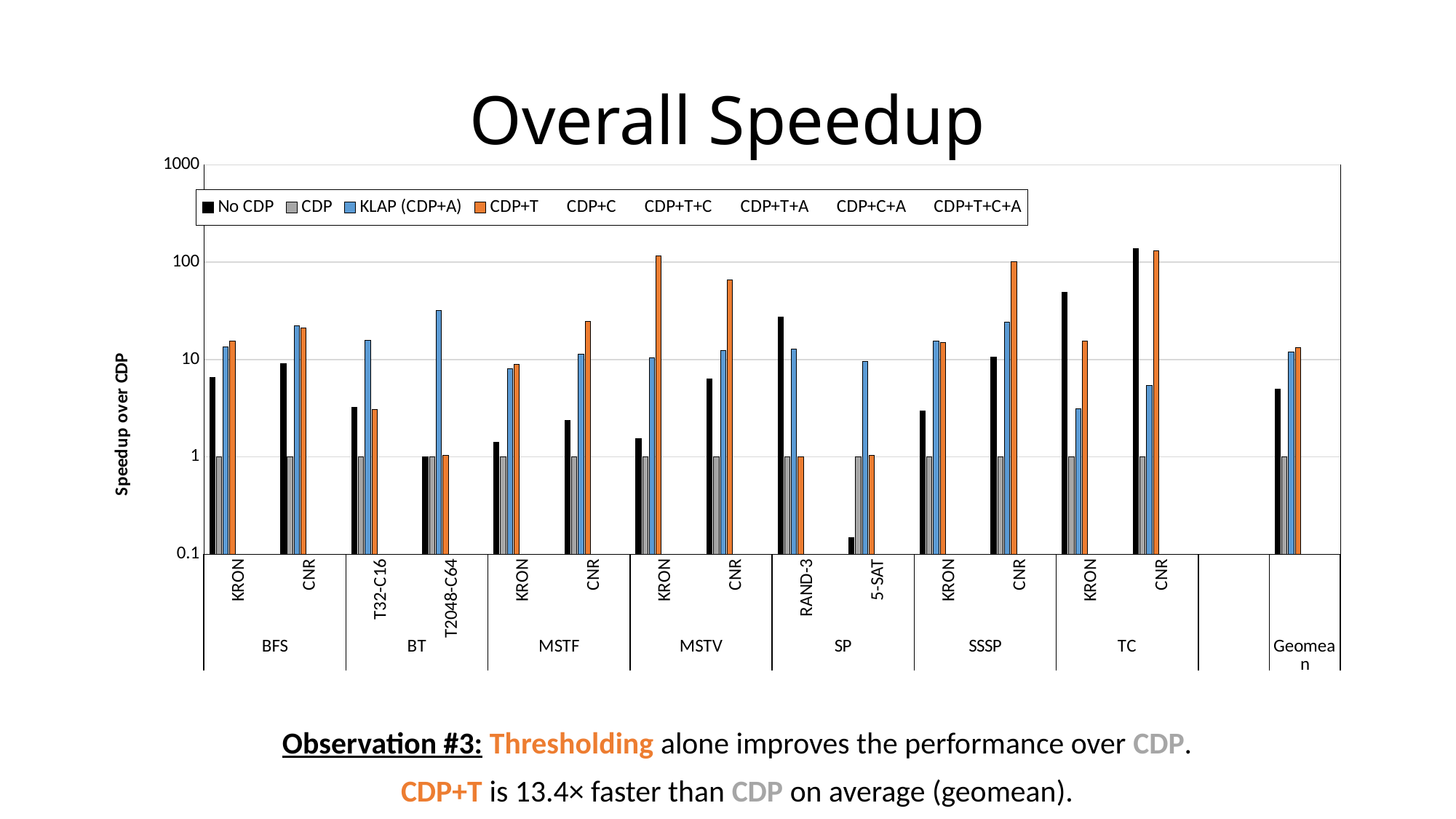
Is the CDP+T value for MSTV KRON greater or less than 100? greater Is the KLAP (CDP+A) value for BT T2048-C64 greater or less than 10? greater What is the Geomean speedup of CDP+T over CDP? 13.4× What is the title of the chart? Overall Speedup For SP RAND-3, which is larger: No CDP or KLAP (CDP+A)? No CDP How many benchmark groups are shown on the x axis, not counting Geomean? 7 Is the No CDP value for SP 5-SAT greater or less than 1? less What is the value of the CDP bar for every input? 1 For BT T2048-C64, which is larger: KLAP (CDP+A) or CDP+T? KLAP (CDP+A) What kind of chart is shown on the slide? bar chart What is the label of the vertical axis? Speedup over CDP How many series are plotted as bars in the chart? 4